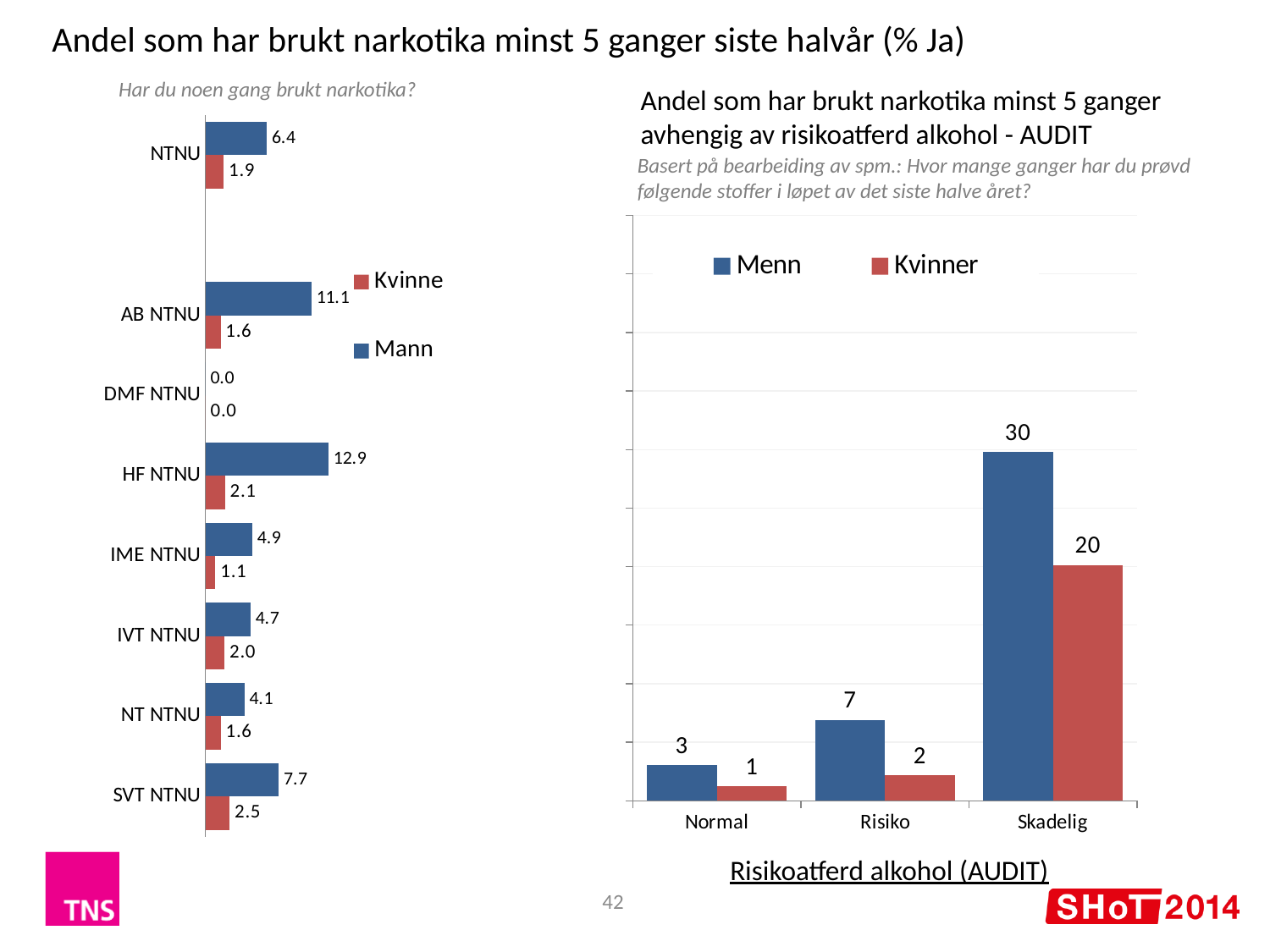
In the left chart, what is the value for Mann at HF NTNU? 12.9 In the right chart, what is the value for Menn at Skadelig? 30 In the left chart, what is the value for Kvinne at SVT NTNU? 2.5 In the left chart, how many categories are shown on the vertical axis? 8 In the right chart, what is the difference between Menn and Kvinner at Skadelig? 10 In the left chart, which category has the highest Mann value? HF NTNU In the left chart, what is the difference between the Mann and Kvinne values at AB NTNU? 9.5 In the left chart, which category has the lowest Kvinne value? DMF NTNU In the left chart, how many series does the legend list? 2 What kind of chart is the right chart? bar chart In the right chart, do the Menn values rise or fall from Normal to Skadelig? rise In the right chart, which is larger at Risiko: Menn or Kvinner? Menn